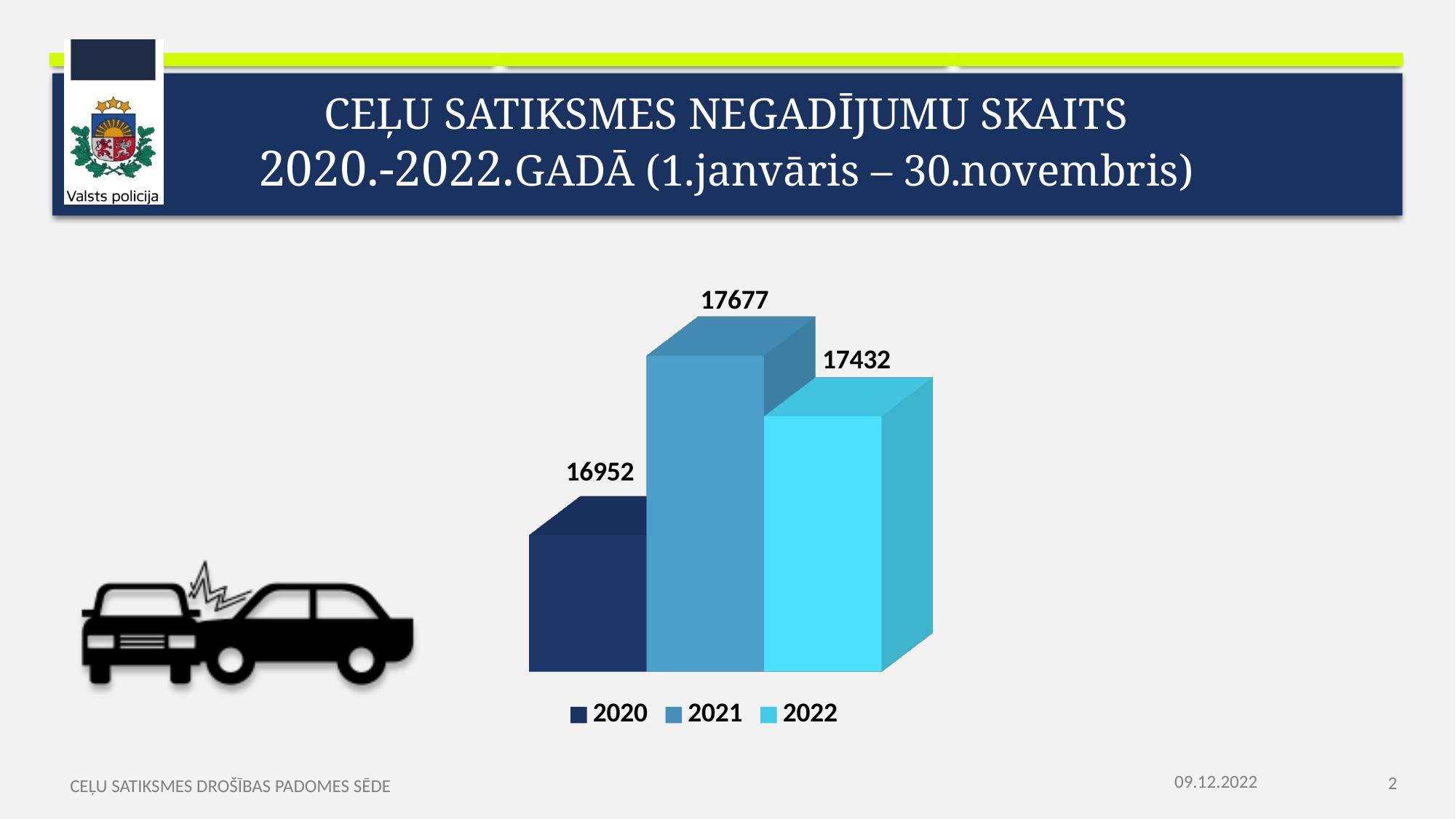
Which is larger, the value for 2022 or the value for 2020? 2022 What is the value for 2020? 16952 What is the difference between the values for 2021 and 2020? 725 What is the value for 2022? 17432 How many bars are shown in the chart? 3 What is the value for 2021? 17677 Which year has the lowest value? 2020 What kind of chart is shown on the slide? bar chart How many entries does the legend list? 3 Which year has the highest value? 2021 What is the difference between the values for 2021 and 2022? 245 Which legend entry is shown in the lightest blue colour? 2022